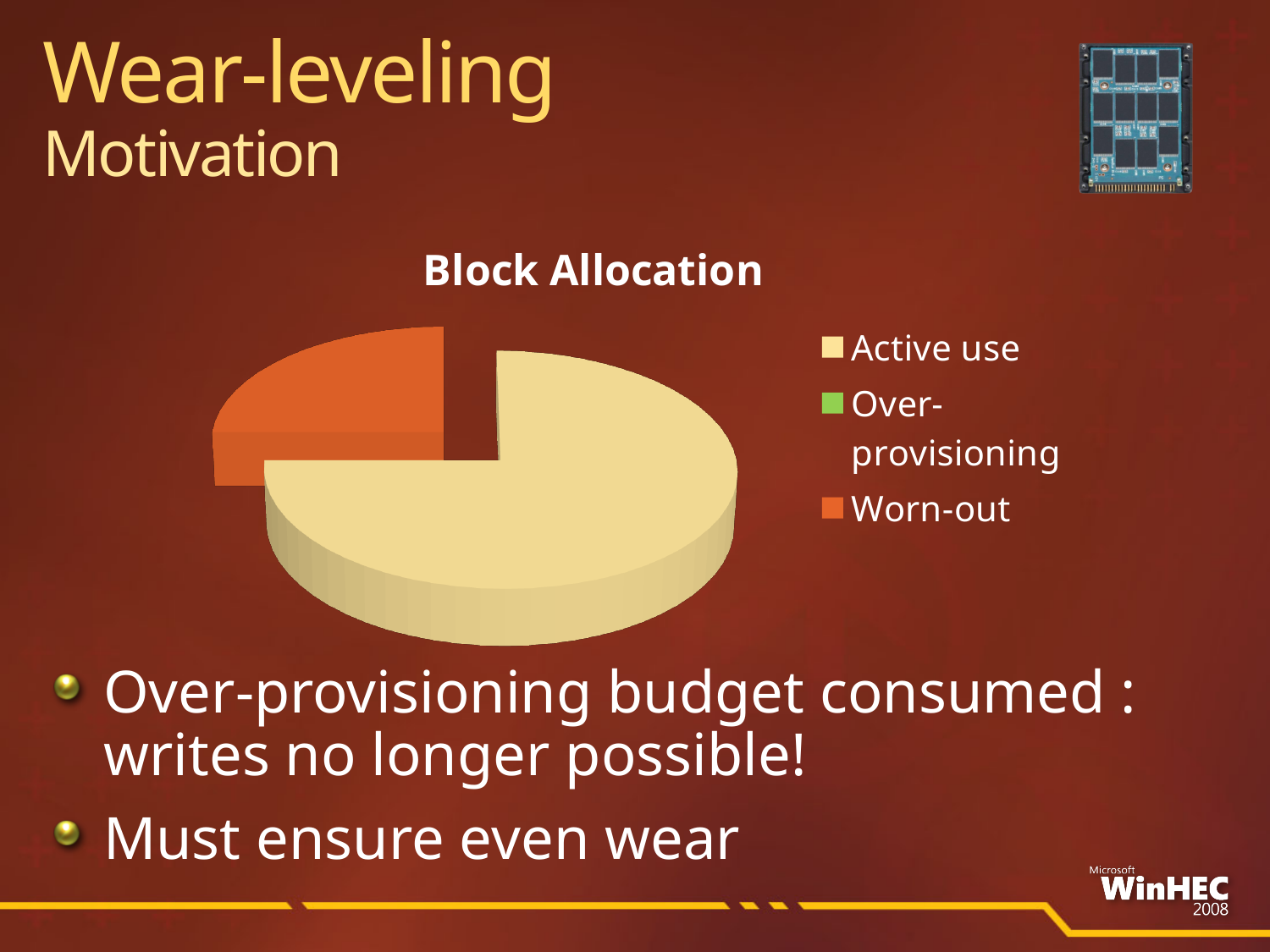
What kind of chart is shown on the slide? Pie chart Which legend entry has no visible slice in the pie? Over-provisioning What is the title of the chart? Block Allocation Which category takes up the largest share of the pie? Active use Which category is represented by the orange slice? Worn-out Which is larger in the pie, Active use or Worn-out? Active use How many entries does the chart's legend list? 3